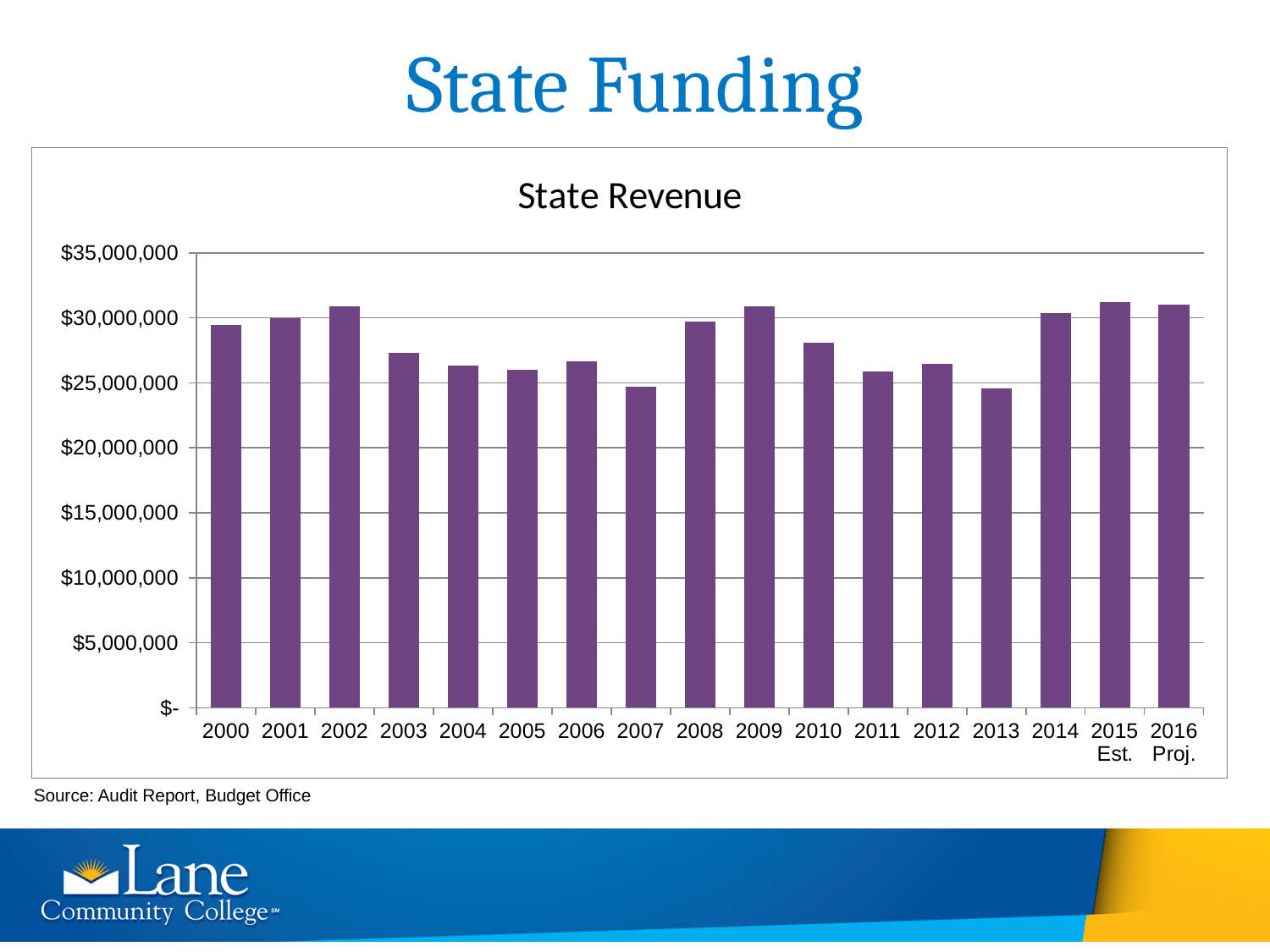
How many years (bars) are shown on the x axis of the State Revenue chart? 17 Do the values rise or fall from 2009 to 2013? fall Is the value for 2011 greater or less than $30,000,000? less Is the value for 2002 greater or less than $30,000,000? greater Is the value for 2015 Est. greater or less than $30,000,000? greater Which is larger, the value for 2002 or the value for 2003? 2002 Which is larger, the value for 2013 or the value for 2014? 2014 What is the title of the chart? State Revenue What kind of chart is shown on the slide? bar chart Which is larger, the value for 2007 or the value for 2008? 2008